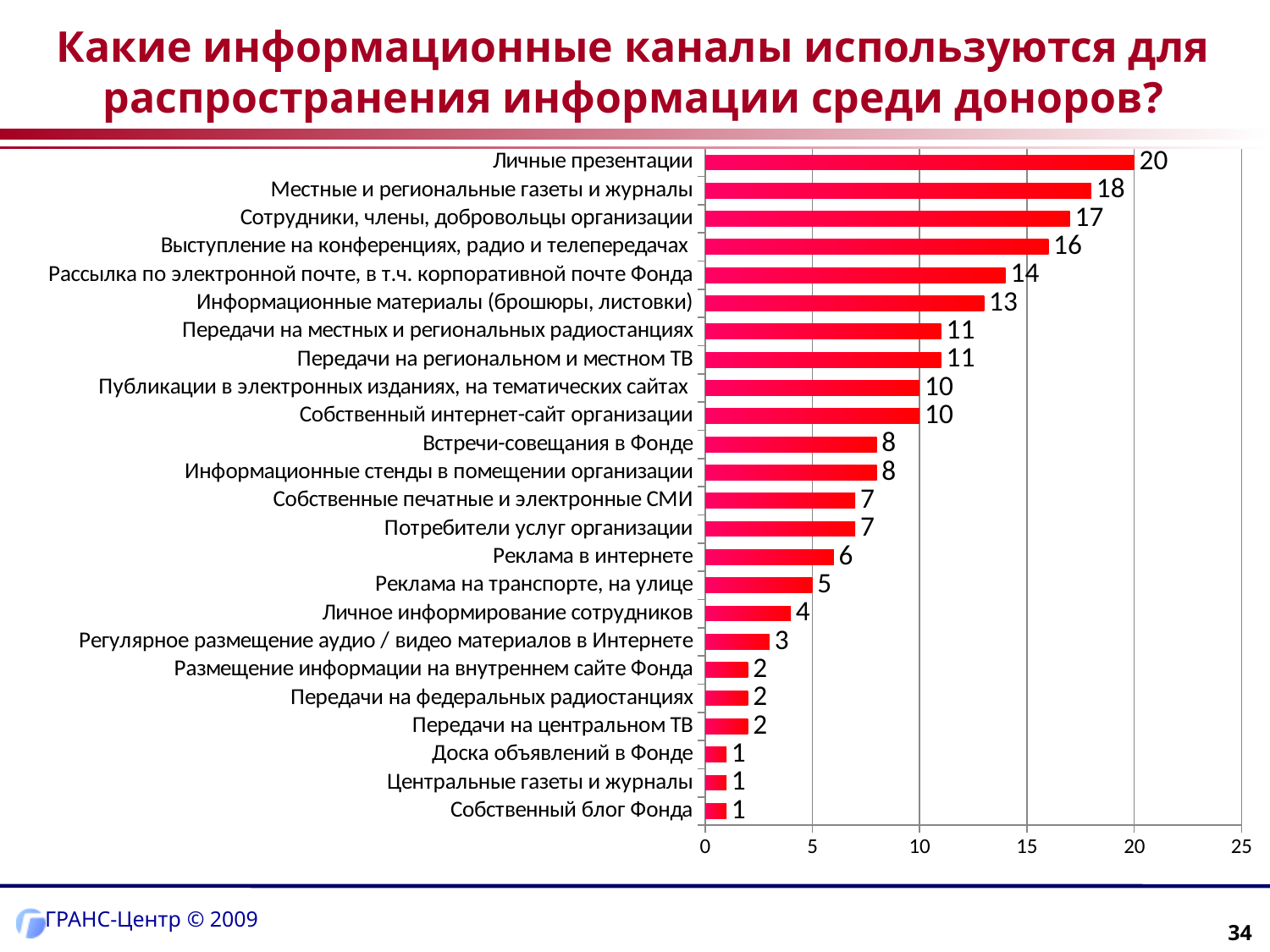
What is the maximum value shown on the horizontal axis? 25 What is the difference between the values for Информационные материалы (брошюры, листовки) and Реклама на транспорте, на улице? 8 What is the difference between the values for Личные презентации and Местные и региональные газеты и журналы? 2 Which has a larger value: Сотрудники, члены, добровольцы организации or Собственный интернет-сайт организации? Сотрудники, члены, добровольцы организации What value is shown for Реклама в интернете? 6 How many information channels (categories) are shown in the chart? 24 Which has a larger value: Личное информирование сотрудников or Встречи-совещания в Фонде? Встречи-совещания в Фонде What kind of chart is shown on the slide? Bar chart What value is shown for Передачи на центральном ТВ? 2 What value is shown for Рассылка по электронной почте, в т.ч. корпоративной почте Фонда? 14 Which information channel has the highest value? Личные презентации What value is shown for Личные презентации? 20